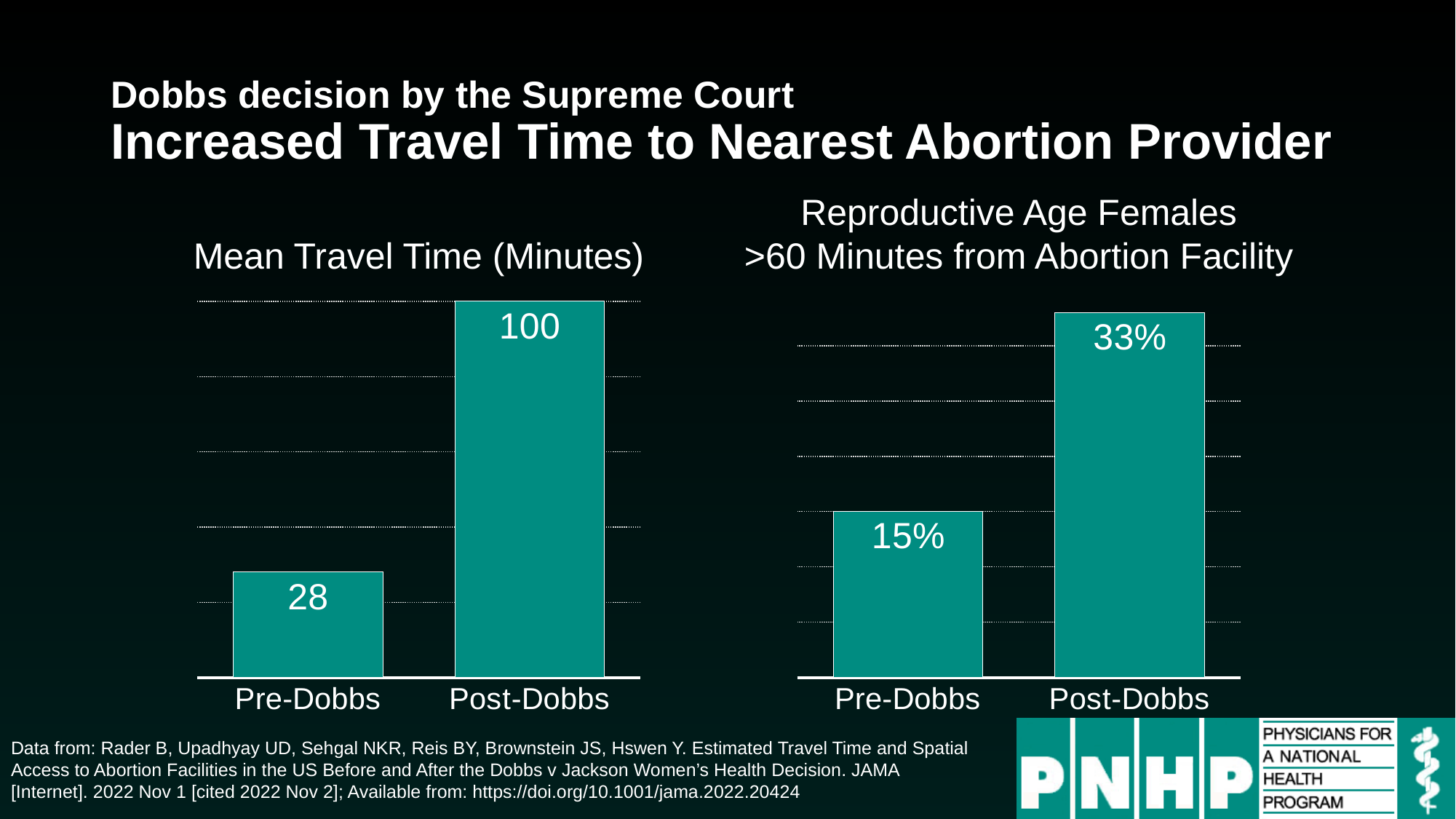
In the 'Reproductive Age Females >60 Minutes from Abortion Facility' chart, what is the value for Post-Dobbs? 33% How many categories are shown in the 'Mean Travel Time (Minutes)' chart? 2 In the 'Reproductive Age Females >60 Minutes from Abortion Facility' chart, what is the value for Pre-Dobbs? 15% How many charts are shown on the slide? 2 In the 'Reproductive Age Females >60 Minutes from Abortion Facility' chart, which category has the lowest value? Pre-Dobbs What kind of chart is the 'Mean Travel Time (Minutes)' chart? Bar chart In the 'Reproductive Age Females >60 Minutes from Abortion Facility' chart, what is the difference between the Post-Dobbs and Pre-Dobbs values? 18% In the 'Mean Travel Time (Minutes)' chart, what is the difference between the Post-Dobbs and Pre-Dobbs values? 72 In the 'Mean Travel Time (Minutes)' chart, what is the value for Post-Dobbs? 100 In the 'Mean Travel Time (Minutes)' chart, which category has the highest value? Post-Dobbs In the 'Reproductive Age Females >60 Minutes from Abortion Facility' chart, which is larger, Pre-Dobbs or Post-Dobbs? Post-Dobbs In the 'Mean Travel Time (Minutes)' chart, what is the value for Pre-Dobbs? 28